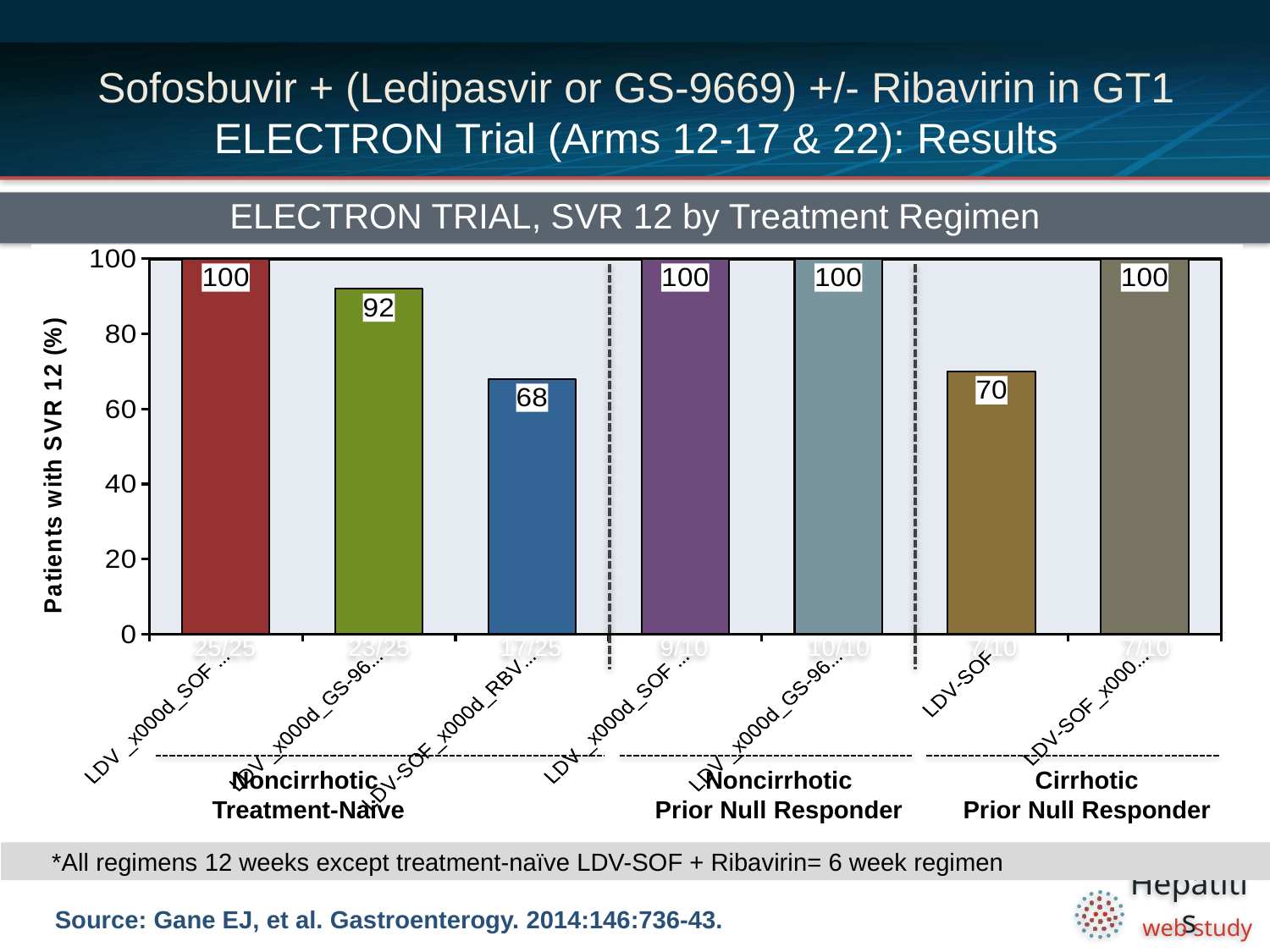
What is the difference between the first bar in the Noncirrhotic Treatment-Naïve group and the LDV-SOF bar in the Cirrhotic Prior Null Responder group? 30 What is the difference between the second and third bars in the Noncirrhotic Treatment-Naïve group? 24 How many bars are plotted in the chart? 7 Which bar has the lowest value in the chart? the third bar in the Noncirrhotic Treatment-Naïve group (68) What is the value of the first (leftmost) bar in the Noncirrhotic Treatment-Naïve group? 100 Which is larger: the LDV-SOF bar in the Cirrhotic Prior Null Responder group or the third bar in the Noncirrhotic Treatment-Naïve group? the LDV-SOF bar in the Cirrhotic Prior Null Responder group What is the value of the LDV-SOF bar in the Cirrhotic Prior Null Responder group? 70 What is the label of the y axis? Patients with SVR 12 (%) What is the value of the third bar in the Noncirrhotic Treatment-Naïve group? 68 What kind of chart is shown on the slide? bar chart What is the chart's title? ELECTRON TRIAL, SVR 12 by Treatment Regimen What is the value of the second bar in the Noncirrhotic Treatment-Naïve group? 92